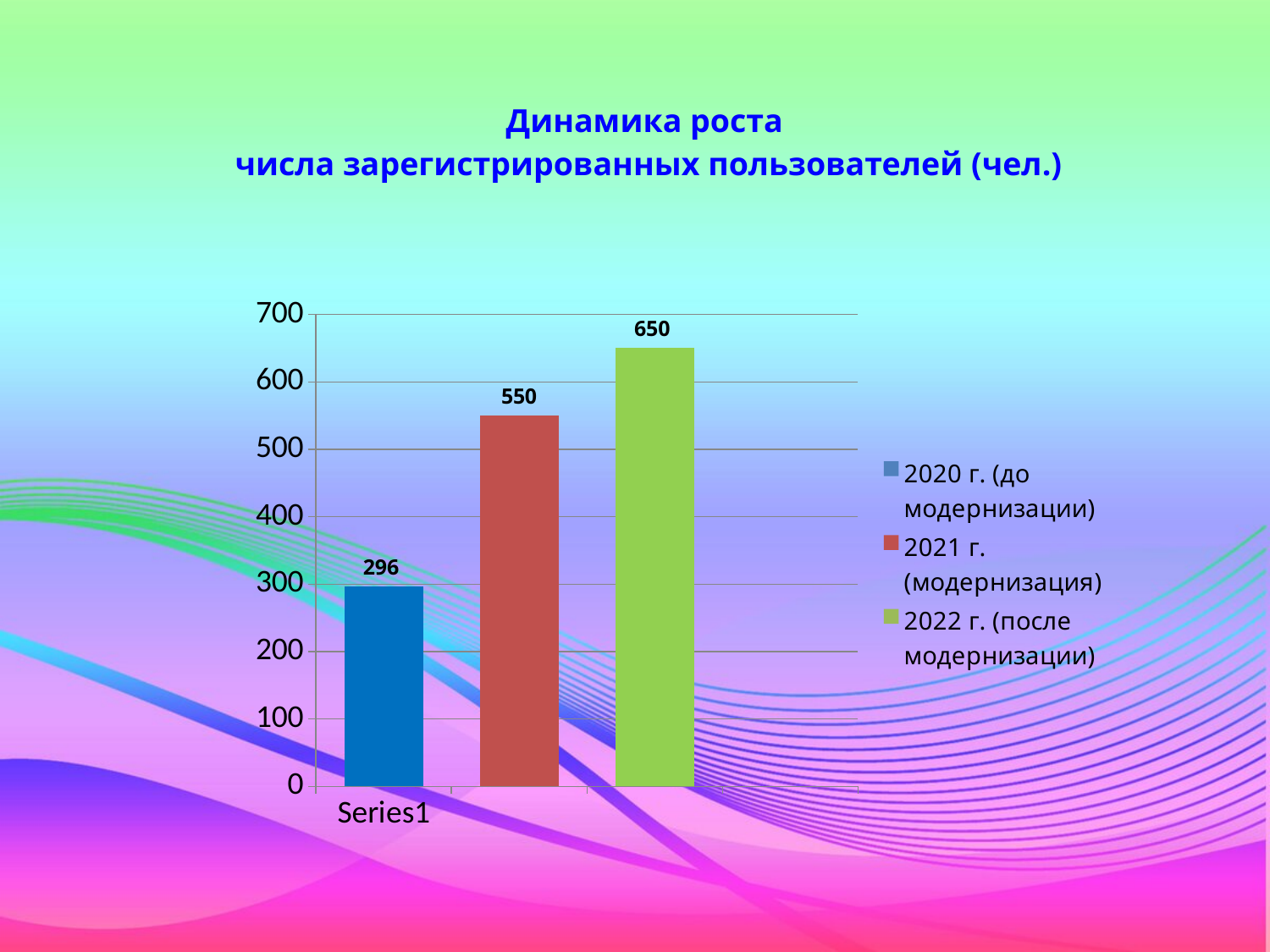
What kind of chart is shown on the slide? bar chart Which series has the highest value? 2022 г. (после модернизации) How many series does the legend list? 3 What colour is the bar for 2021 г. (модернизация)? red What is the difference between the values for 2021 г. (модернизация) and 2020 г. (до модернизации)? 254 What is the difference between the values for 2022 г. (после модернизации) and 2020 г. (до модернизации)? 354 Is the value for 2020 г. (до модернизации) greater or less than 300? less What is the value for 2021 г. (модернизация)? 550 What is the value for 2020 г. (до модернизации)? 296 Which series has the lowest value? 2020 г. (до модернизации) What is the value for 2022 г. (после модернизации)? 650 Which is larger, the value for 2021 г. (модернизация) or the value for 2022 г. (после модернизации)? 2022 г. (после модернизации)